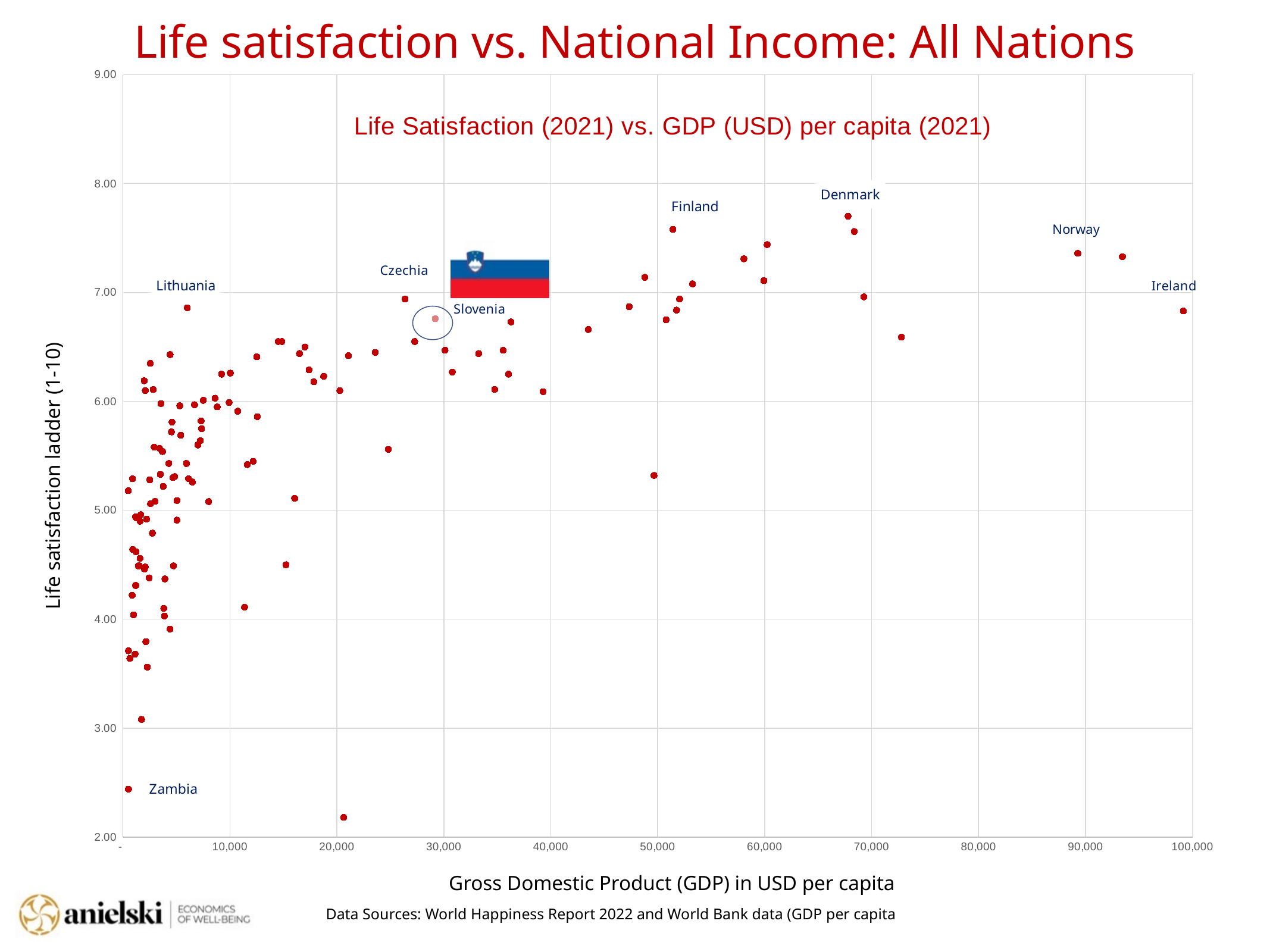
Is the GDP per capita for Norway greater or less than 80,000? greater Which has the higher life satisfaction value, Denmark or Zambia? Denmark Is the GDP per capita for Slovenia greater or less than 40,000? less Is the GDP per capita for Ireland greater or less than 90,000? greater What is the title of the chart? Life Satisfaction (2021) vs. GDP (USD) per capita (2021) What kind of chart is shown on the slide? Scatter chart What is the label of the x axis? Gross Domestic Product (GDP) in USD per capita Which has the higher GDP per capita, Ireland or Lithuania? Ireland Do life satisfaction values generally rise or fall as GDP per capita increases along the x axis? Rise